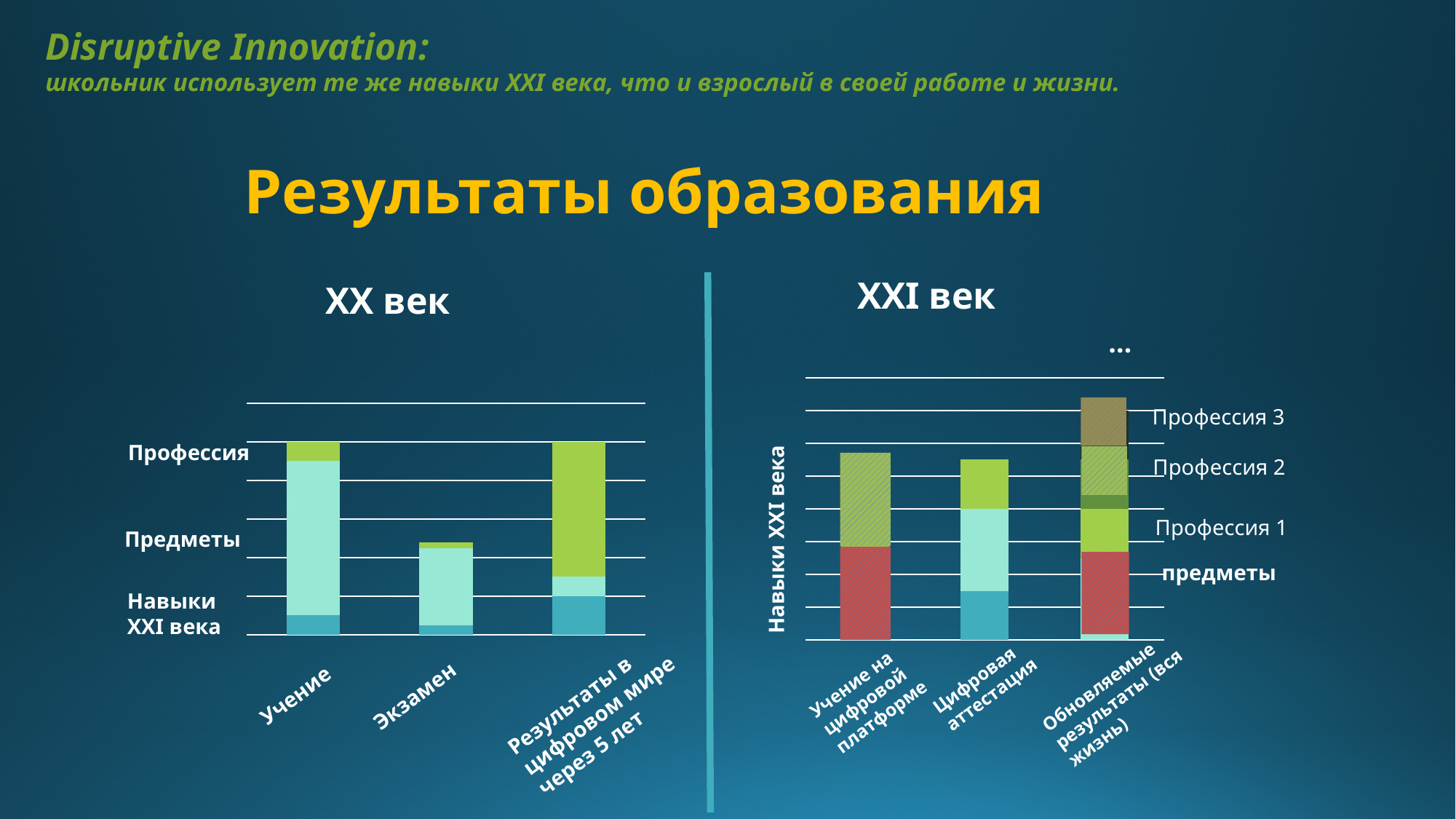
What is the vertical axis label of the "XXI век" chart on the right? Навыки XXI века In the "XX век" chart on the left, which bar is the shortest? Экзамен How many bars does the "XXI век" chart on the right have? 3 In the "XXI век" chart on the right, which bar contains the segment labelled "Профессия 3"? Обновляемые результаты (вся жизнь) In the "XX век" chart on the left, which bar has the largest green segment? Результаты в цифровом мире через 5 лет In the "XXI век" chart on the right, which bar is taller: "Цифровая аттестация" or "Обновляемые результаты (вся жизнь)"? Обновляемые результаты (вся жизнь) What kind of chart is the "XX век" chart on the left? Stacked bar chart What three labels appear along the vertical axis of the "XX век" chart on the left? Профессия, Предметы, Навыки XXI века How many bars does the "XX век" chart on the left have? 3 In the "XX век" chart on the left, which bar is taller: "Учение" or "Экзамен"? Учение In the "XXI век" chart on the right, which bar is the tallest? Обновляемые результаты (вся жизнь)